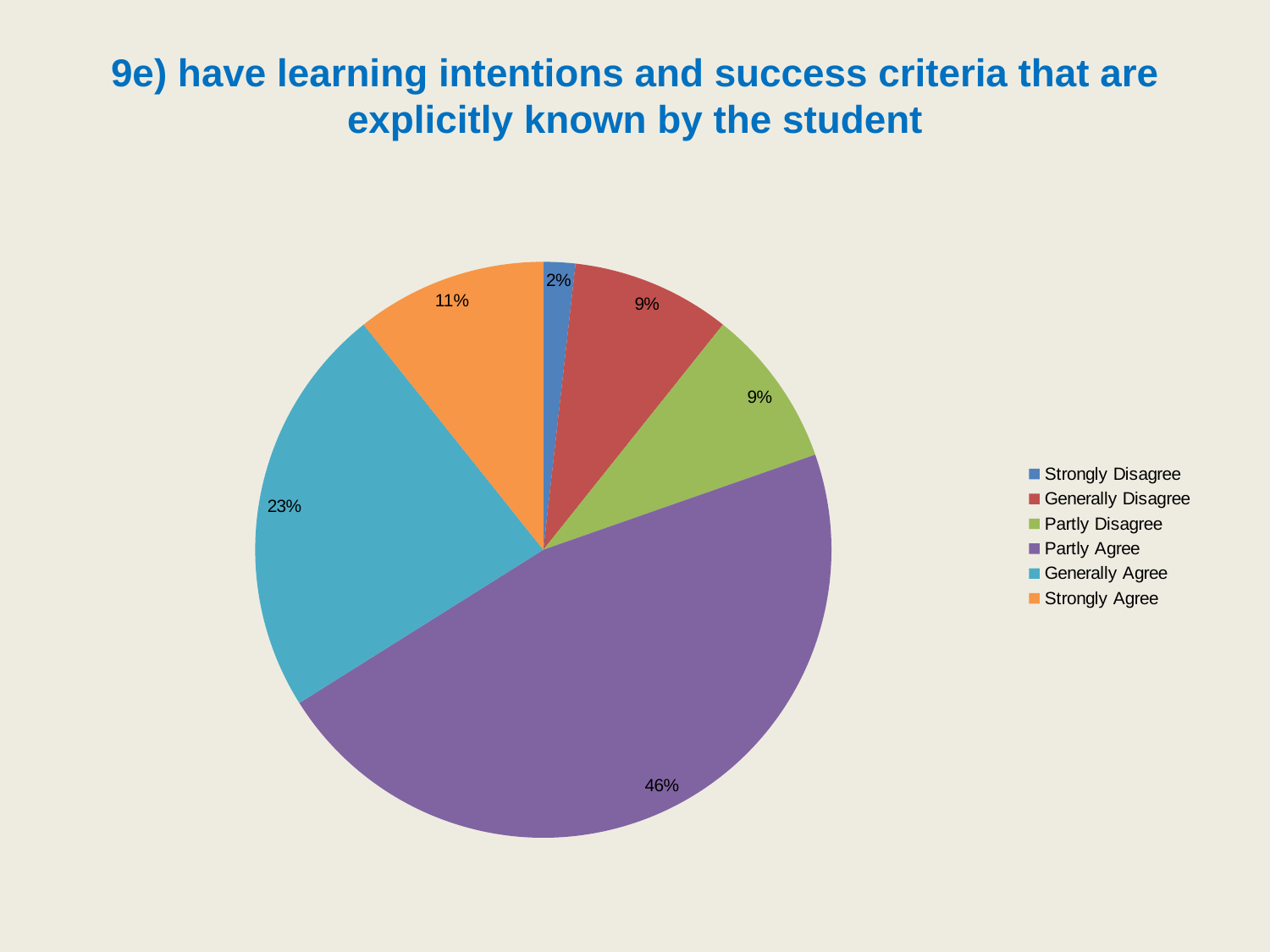
What percentage of respondents chose Partly Agree? 46% What percentage of respondents chose Strongly Disagree? 2% What percentage of respondents chose Generally Disagree? 9% How many response categories does the legend list? 6 Which response category has the largest share of the pie? Partly Agree What percentage of respondents chose Generally Agree? 23% What kind of chart is shown on the slide? pie chart Which is larger, the share for Generally Agree or the share for Strongly Agree? Generally Agree What is the difference in percentage points between Partly Agree and Generally Agree? 23 What colour is the Partly Agree slice? purple What percentage of respondents chose Strongly Agree? 11% Which response category has the smallest share of the pie? Strongly Disagree